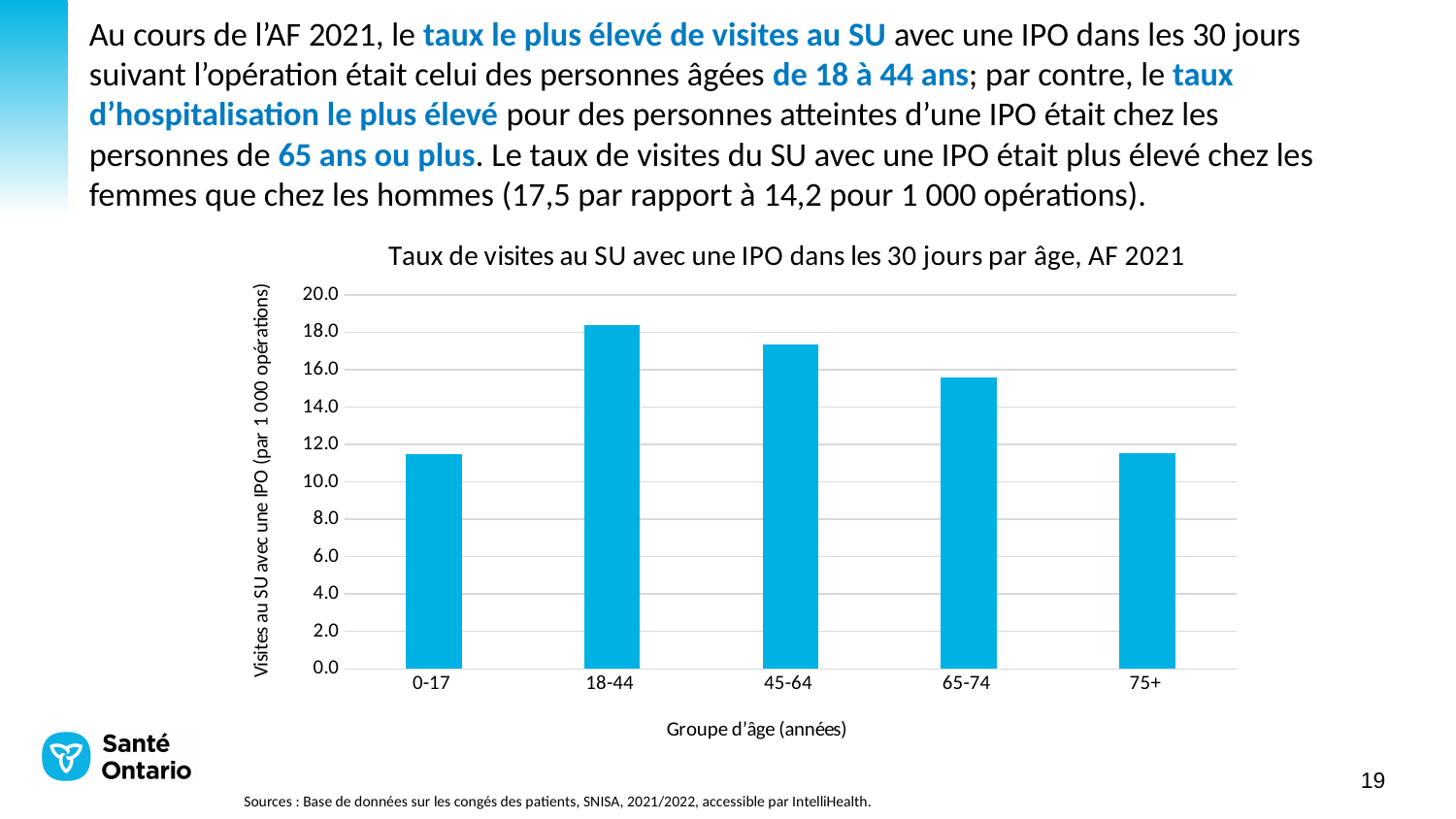
How many age groups are shown on the x axis of the chart? 5 Which has a higher value, the 0-17 age group or the 65-74 age group? 65-74 What is the title of the chart? Taux de visites au SU avec une IPO dans les 30 jours par âge, AF 2021 Is the value for the 0-17 age group greater or less than 12.0? less Is the value for the 45-64 age group greater or less than 16.0? greater Which has a higher value, the 45-64 age group or the 65-74 age group? 45-64 Is the value for the 65-74 age group greater or less than 16.0? less Do the values rise or fall across the age groups from 18-44 to 75+? fall What kind of chart is shown on the slide? bar chart Which age group has the highest rate of ED visits with an SSI within 30 days? 18-44